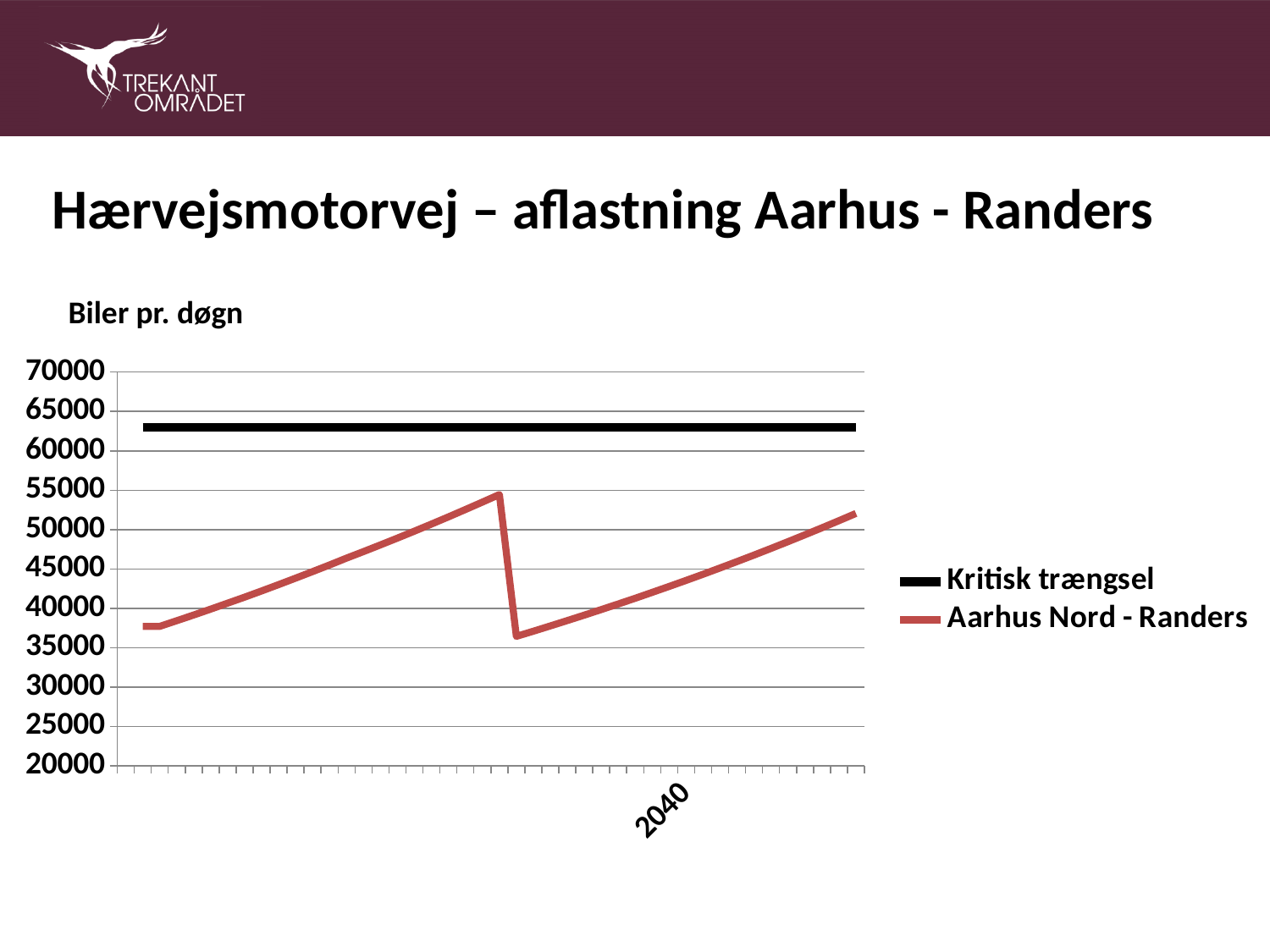
Is the highest value of the Aarhus Nord - Randers line greater or less than 50000? greater Which series is drawn as a black line? Kritisk trængsel Does the Kritisk trængsel line rise, fall or stay flat along the x axis? stays flat How many series does the legend list? 2 What is the label shown above the vertical axis? Biler pr. døgn Does the Aarhus Nord - Randers line rise or fall immediately after reaching its peak? fall Which series has higher values throughout the chart, Kritisk trængsel or Aarhus Nord - Randers? Kritisk trængsel Is the value of the Kritisk trængsel line greater or less than 65000? less Is the value of the Aarhus Nord - Randers line at the right end of the chart greater or less than 50000? greater What kind of chart is shown on the slide? line chart